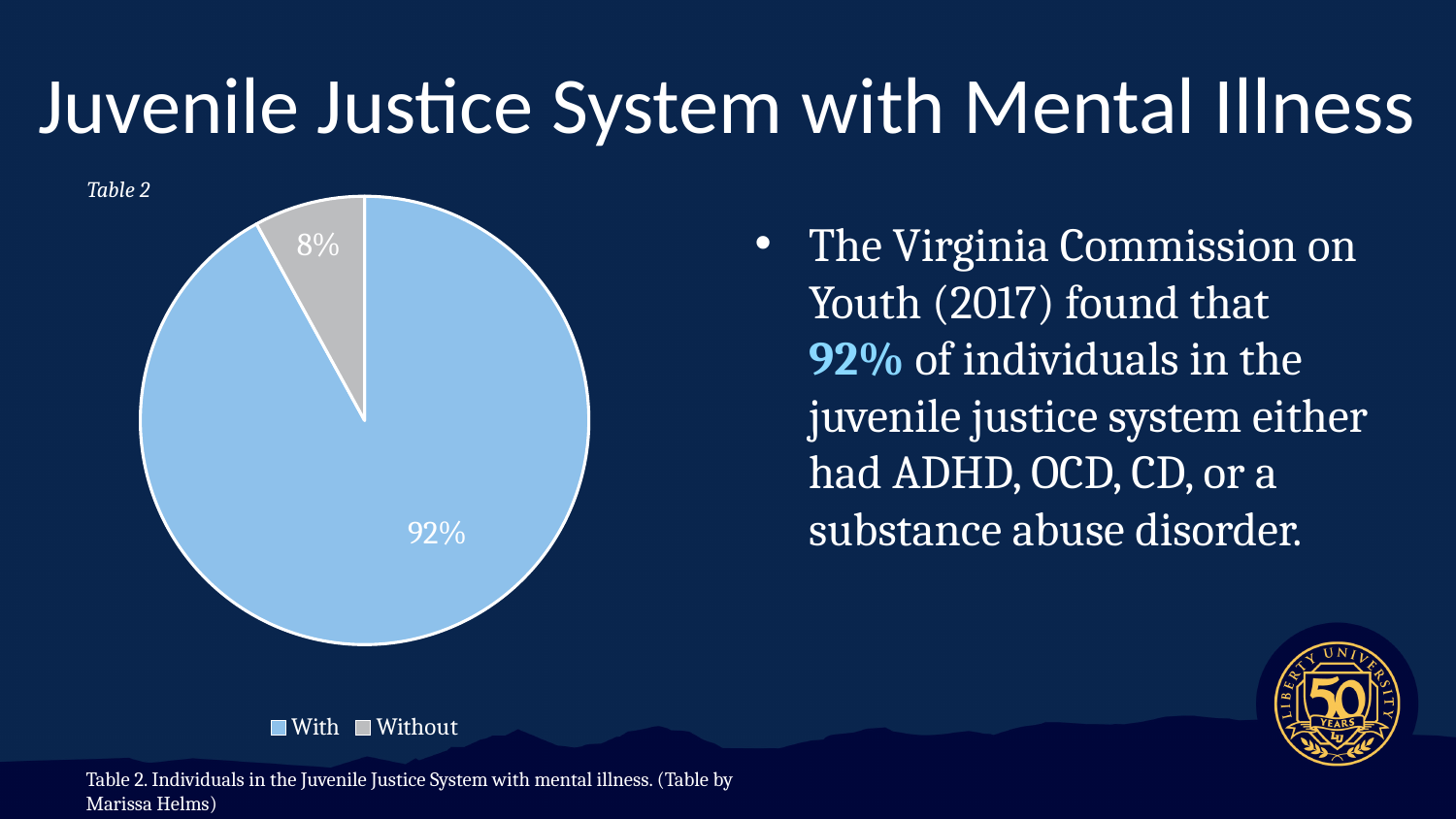
What percentage is shown for the "Without" slice of the pie chart? 8% What percentage is shown for the "With" slice of the pie chart? 92% How many slices does the pie chart have? 2 What share of the pie does the "Without" slice represent? 8% What colour is the "With" slice in the pie chart? light blue Which slice of the pie chart is the smallest? Without What label appears above the pie chart? Table 2 Which slice of the pie chart is the largest? With What type of chart is shown on the slide? pie chart How many entries does the legend of the pie chart list? 2 Which is larger, the "With" slice or the "Without" slice? With What is the difference in percentage points between the "With" and "Without" slices? 84